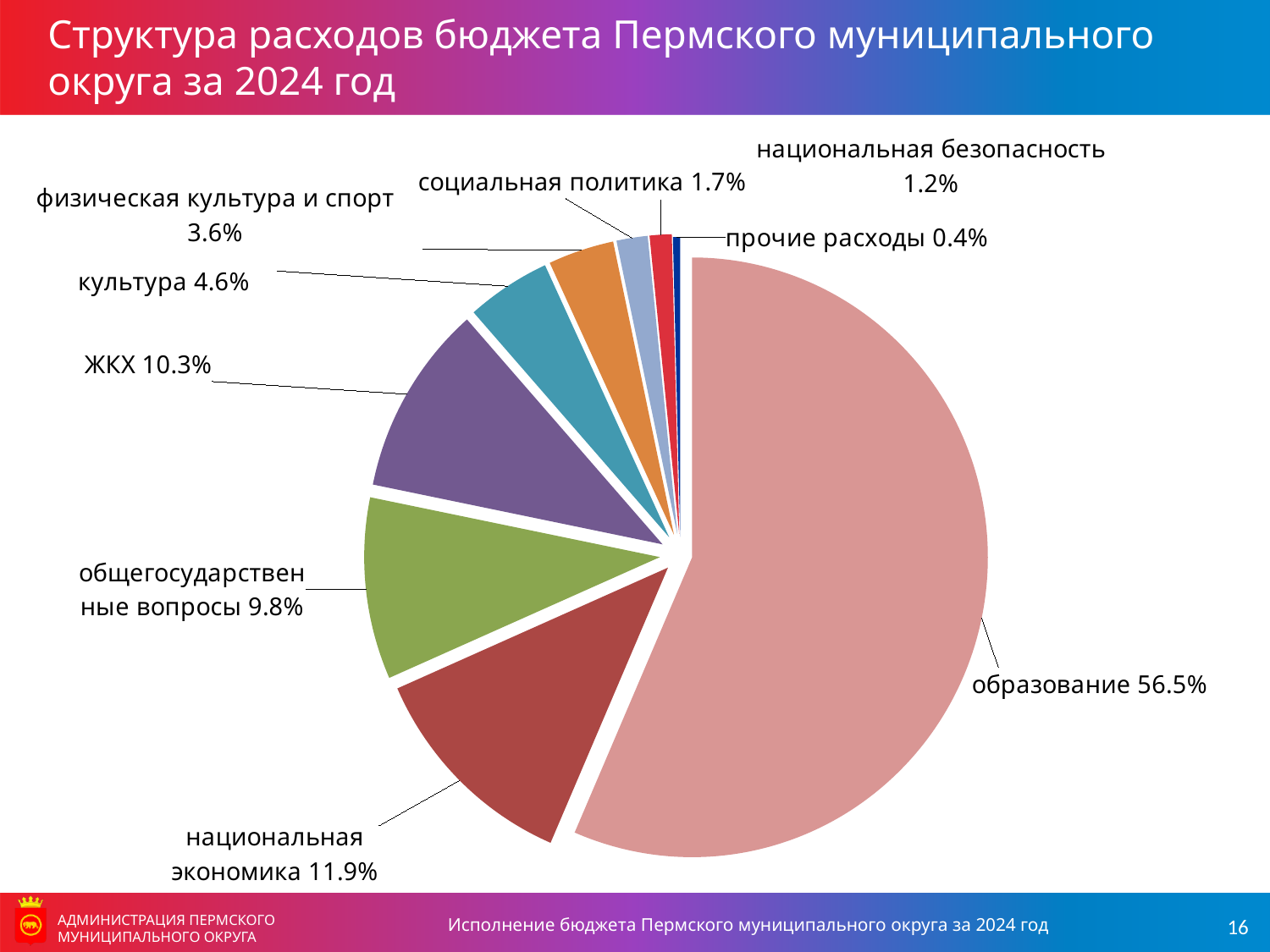
What is the share for ЖКХ? 10.3% What is the difference in percentage points between ЖКХ and общегосударственные вопросы? 0.5 Which is larger: the share for физическая культура и спорт or the share for социальная политика? физическая культура и спорт How many categories are shown in the pie chart? 9 What is the share for прочие расходы? 0.4% What is the share for национальная экономика? 11.9% Which category has the largest share of expenditures? образование What share of budget expenditures goes to образование? 56.5% Which category has the smallest share of expenditures? прочие расходы What type of chart is shown on the slide? pie chart What is the title of the chart on the slide? Структура расходов бюджета Пермского муниципального округа за 2024 год What is the share for культура? 4.6%